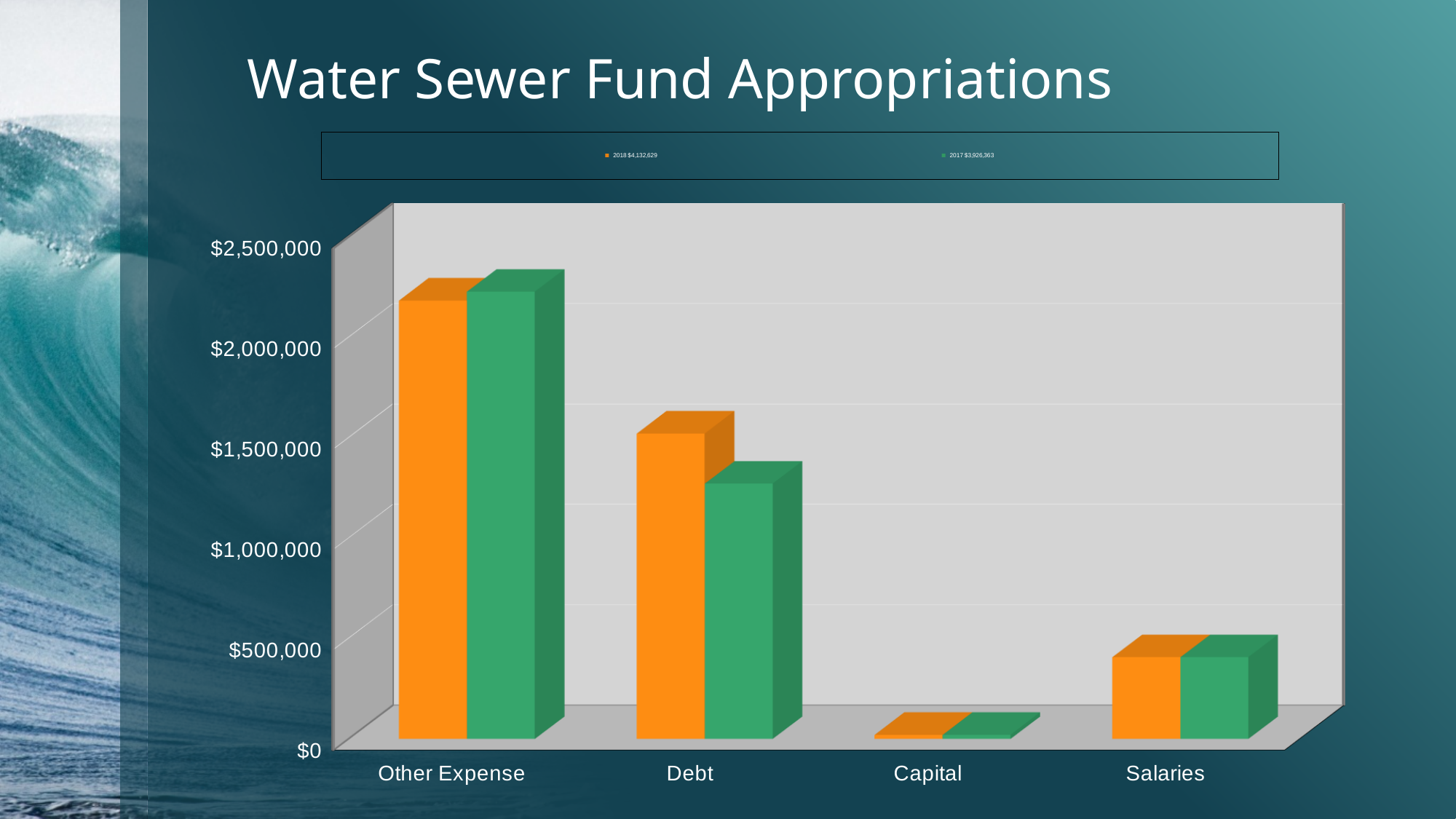
Is the 2018 value for Debt greater or less than $1,000,000? greater What kind of chart is shown on the slide? Bar chart Which category has the lowest value for the 2017 series? Capital Is the 2018 value for Other Expense greater or less than $2,000,000? greater How many series does the chart's legend list? 2 How many categories are shown on the x axis of the chart? 4 Is the 2017 value for Salaries greater or less than $500,000? less What is the title of the chart on the slide? Water Sewer Fund Appropriations For Debt, which series has the larger value, 2018 or 2017? 2018 Which category has the highest value for the 2018 series? Other Expense Which colour represents the 2017 series in the chart? Green